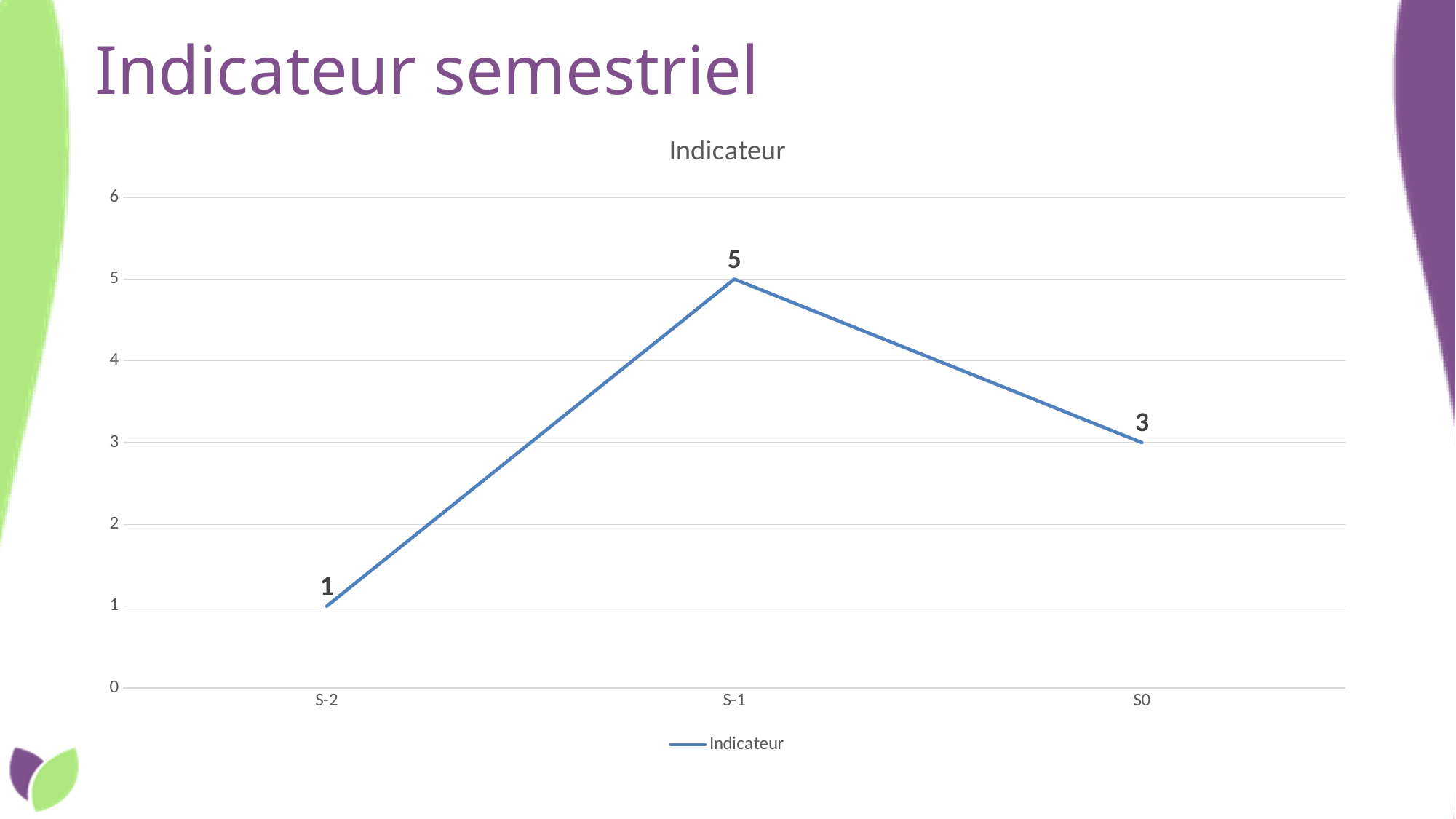
What kind of chart is shown on the slide? line chart What is the difference between the Indicateur values at S-1 and S0? 2 What is the value of the Indicateur at S-2? 1 Is the Indicateur value at S-1 greater or less than 4? greater What is the value of the Indicateur at S-1? 5 What is the difference between the Indicateur values at S0 and S-2? 2 How many series does the legend list? 1 Which period has the highest Indicateur value? S-1 Which period has the lowest Indicateur value? S-2 What is the value of the Indicateur at S0? 3 Which is larger, the Indicateur value at S-2 or at S0? S0 How many periods are plotted on the x axis? 3